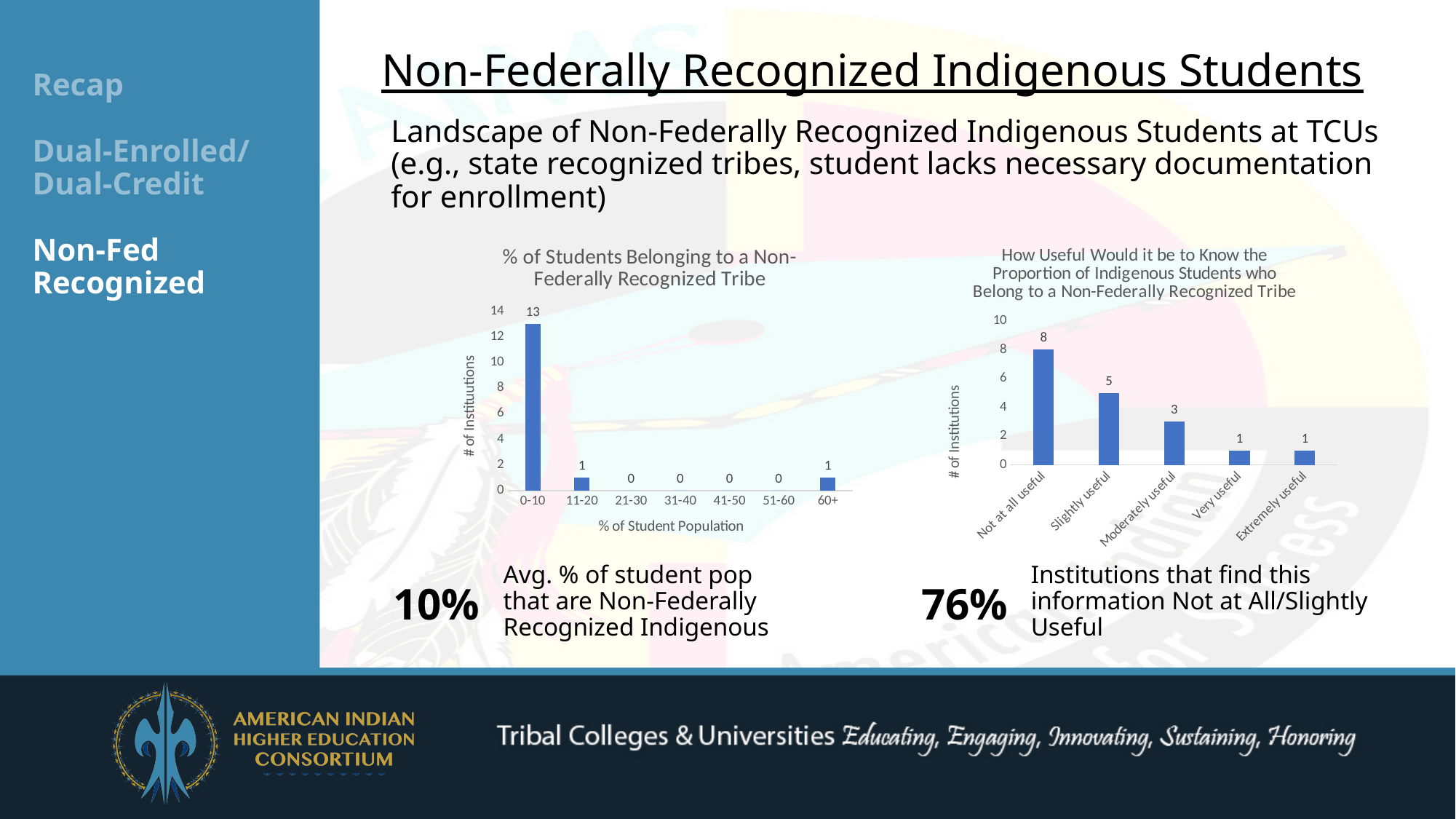
In the right chart 'How Useful Would it be to Know the Proportion of Indigenous Students who Belong to a Non-Federally Recognized Tribe', what is the difference between 'Not at all useful' and 'Slightly useful'? 3 In the right chart 'How Useful Would it be to Know the Proportion of Indigenous Students who Belong to a Non-Federally Recognized Tribe', how many institutions answered 'Moderately useful'? 3 In the left chart '% of Students Belonging to a Non-Federally Recognized Tribe', what is the difference between the 0-10 and 11-20 categories? 12 What kind of chart is the right chart 'How Useful Would it be to Know the Proportion of Indigenous Students who Belong to a Non-Federally Recognized Tribe'? bar chart In the right chart 'How Useful Would it be to Know the Proportion of Indigenous Students who Belong to a Non-Federally Recognized Tribe', how many institutions answered 'Slightly useful'? 5 In the left chart '% of Students Belonging to a Non-Federally Recognized Tribe', how many categories are shown on the x axis? 7 In the left chart '% of Students Belonging to a Non-Federally Recognized Tribe', how many institutions are in the 60+ category? 1 In the left chart '% of Students Belonging to a Non-Federally Recognized Tribe', which category has the highest number of institutions? 0-10 In the right chart 'How Useful Would it be to Know the Proportion of Indigenous Students who Belong to a Non-Federally Recognized Tribe', do the values rise or fall from left to right across the categories? fall In the left chart '% of Students Belonging to a Non-Federally Recognized Tribe', how many institutions are in the 0-10 category? 13 In the right chart 'How Useful Would it be to Know the Proportion of Indigenous Students who Belong to a Non-Federally Recognized Tribe', which category has the highest value? Not at all useful In the left chart '% of Students Belonging to a Non-Federally Recognized Tribe', what is the x-axis label? % of Student Population